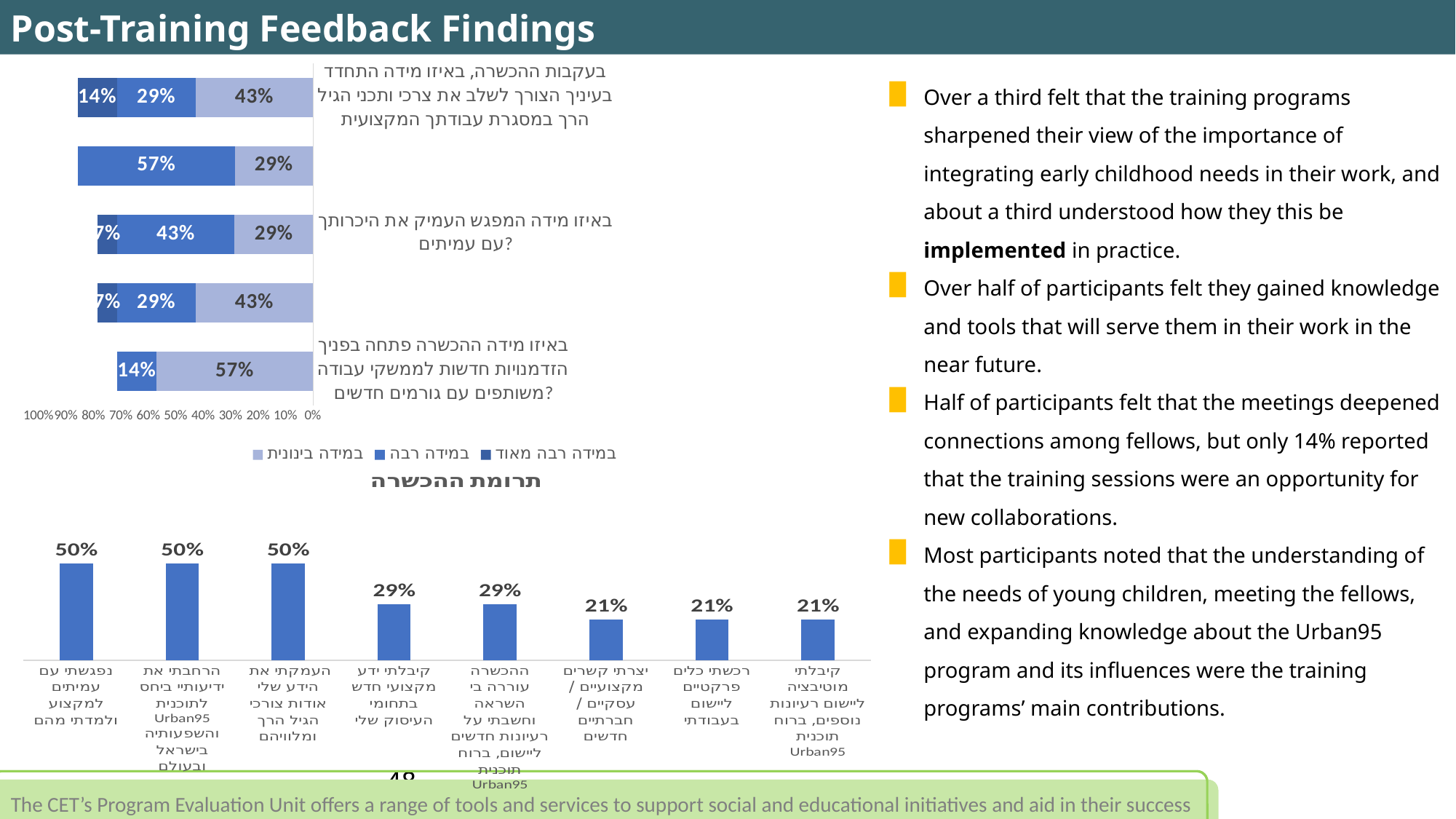
In the bottom chart titled 'תרומת ההכשרה', how many bars (categories) are shown? 8 In the bottom chart titled 'תרומת ההכשרה', which is larger: the value for 'העמקתי את הידע שלי אודות צורכי הגיל הרך ומלוויהם' or the value for 'ההכשרה עוררה בי השראה וחשבתי על רעיונות חדשים ליישום, ברוח תוכנית Urban95'? העמקתי את הידע שלי אודות צורכי הגיל הרך ומלוויהם In the bottom chart titled 'תרומת ההכשרה', what is the difference between the value for 'נפגשתי עם עמיתים למקצוע ולמדתי מהם' and the value for 'יצרתי קשרים מקצועיים / עסקיים / חברתיים חדשים'? 29 percentage points What kind of chart is the bottom chart titled 'תרומת ההכשרה'? bar chart In the bottom chart titled 'תרומת ההכשרה', what is the value for 'קיבלתי ידע מקצועי חדש בתחומי העיסוק שלי'? 29% In the top stacked bar chart, what is the 'במידה בינונית' value for the question 'באיזו מידה ההכשרה פתחה בפניך הזדמנויות חדשות לממשקי עבודה משותפים עם גורמים חדשים?'? 57% In the bottom chart titled 'תרומת ההכשרה', what is the lowest value shown on any bar? 21% In the top stacked bar chart, what is the total of the three segments (14%, 29%, 43%) in the first bar, for the question about integrating early childhood needs into professional work? 86% In the bottom chart titled 'תרומת ההכשרה', what is the value for 'רכשתי כלים פרקטיים ליישום בעבודתי'? 21% In the bottom chart titled 'תרומת ההכשרה', what is the highest value shown on any bar? 50% In the top stacked bar chart, what is the 'במידה רבה' value for the question 'באיזו מידה המפגש העמיק את היכרותך עם עמיתים?'? 43% In the top stacked bar chart, how many series does the legend list? 3